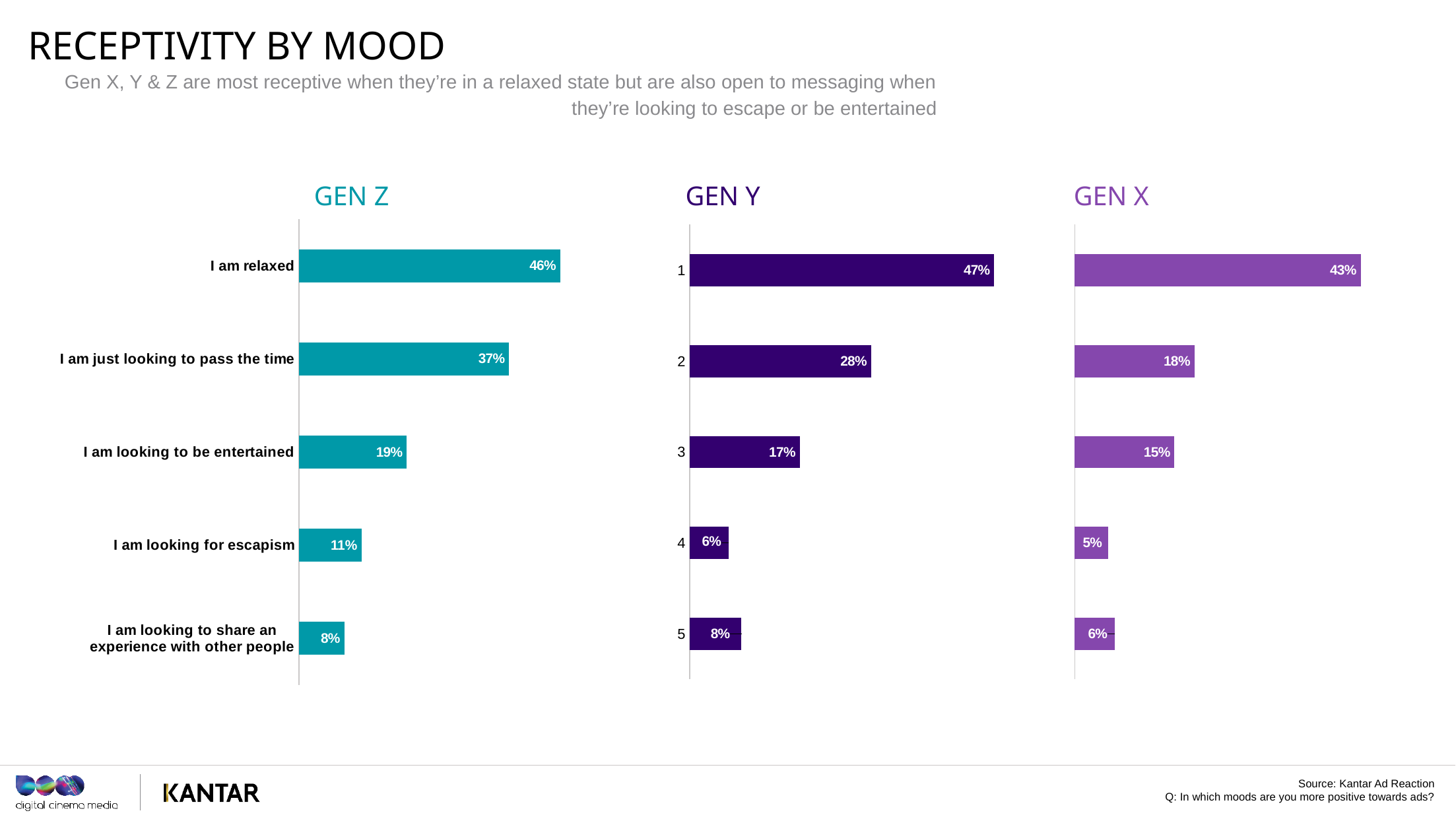
In the GEN Z chart, which category has the highest value? I am relaxed Which is larger: the value for category 2 in the GEN Y chart or the value for category 2 in the GEN X chart? GEN Y In the GEN Z chart, what is the value for "I am looking for escapism"? 11% In the GEN Z chart, what is the difference between "I am relaxed" and "I am just looking to pass the time"? 9% How many categories does the GEN Z chart show? 5 In the GEN X chart, which category has the lowest value? 4 In the GEN Z chart, which category has the lowest value? I am looking to share an experience with other people In the GEN Y chart, what is the value for category 2? 28% What type of chart is the GEN Y chart? Bar chart In the GEN Y chart, what is the difference between category 1 and category 2? 19% In the GEN Z chart, what is the value for "I am relaxed"? 46% In the GEN X chart, what is the value for category 3? 15%